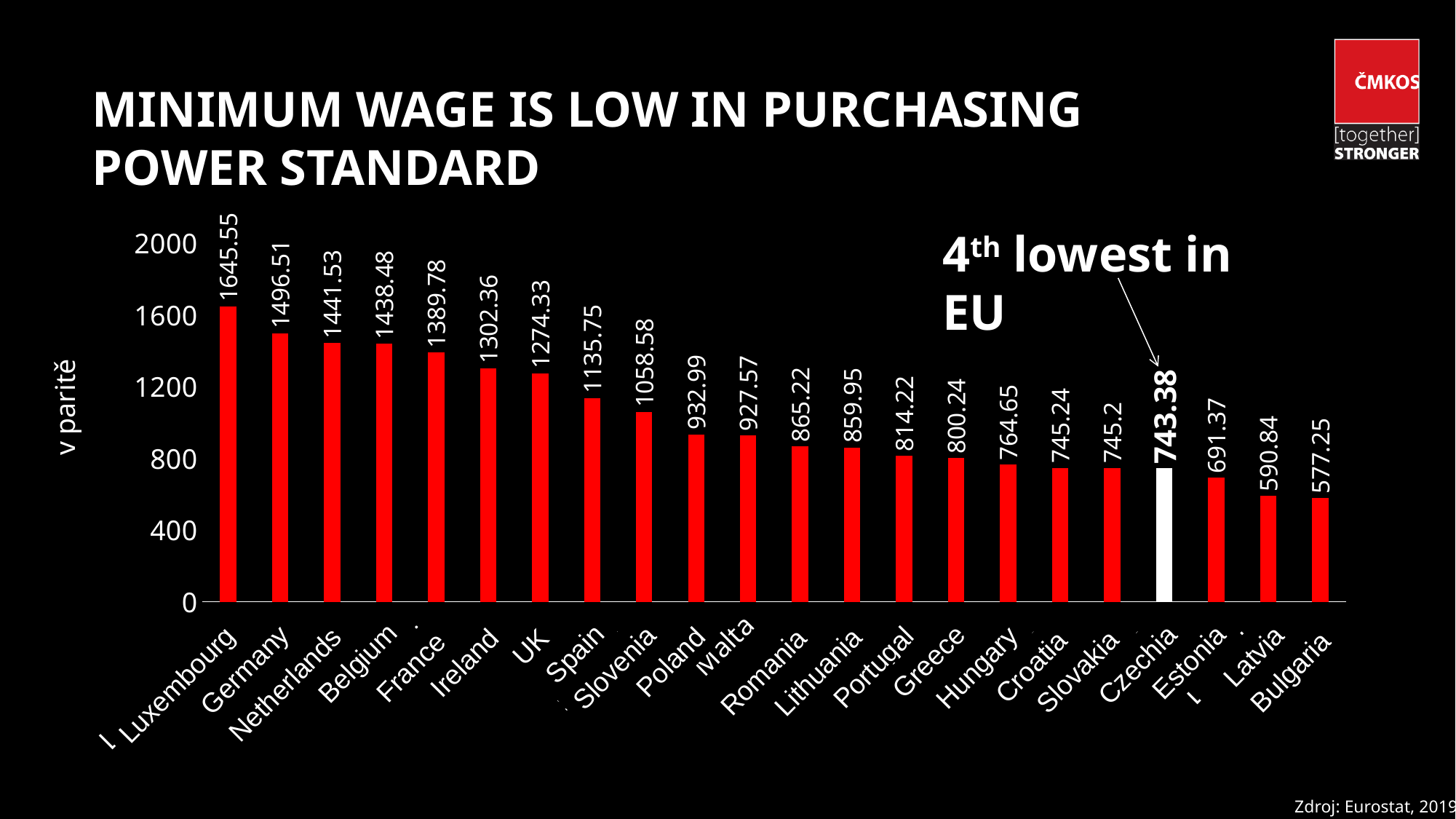
What is the difference between the values for Luxembourg and Bulgaria? 1068.3 Which country has the highest value? Luxembourg Which bar is highlighted in white instead of red? Czechia What is the value for Luxembourg? 1645.55 What is the value for Spain? 1135.75 Which country has the lowest value? Bulgaria What is the difference between the values for Czechia and Bulgaria? 166.13 How many countries are shown in the chart? 22 What is the value for Czechia? 743.38 What is the value for Bulgaria? 577.25 Which has a larger value, Germany or Ireland? Germany What kind of chart is shown on the slide? Bar chart